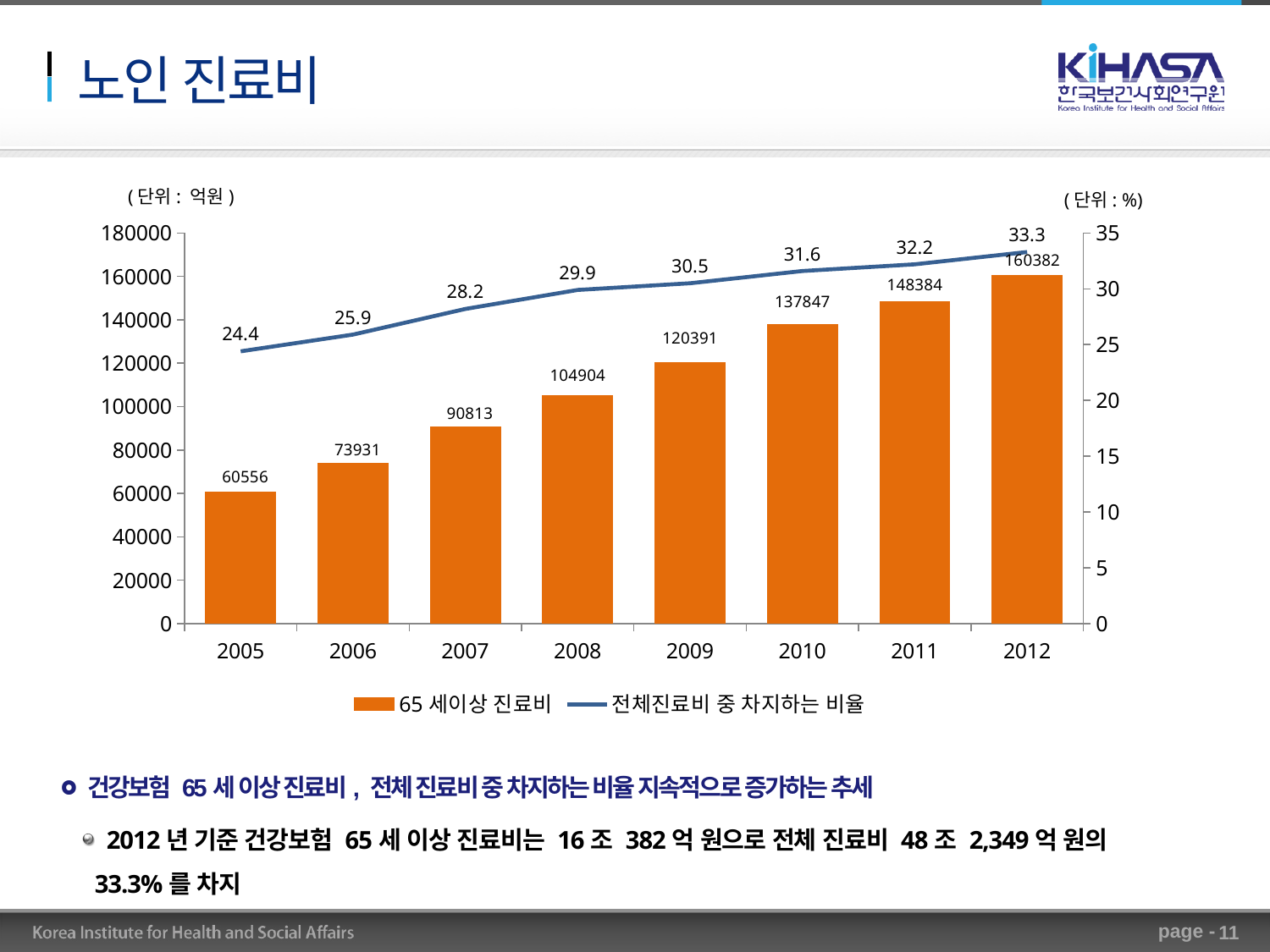
Which is larger, the 65세이상 진료비 for 2008 or for 2006? 2008 How many years are shown on the x axis? 8 What kind of chart is this? Combined bar and line chart Which year has the lowest 전체진료비 중 차지하는 비율? 2005 How many series does the legend list? 2 What is the value of 전체진료비 중 차지하는 비율 for 2007? 28.2 What is the difference in 65세이상 진료비 between 2012 and 2011? 11998 What is the difference in 전체진료비 중 차지하는 비율 between 2010 and 2005? 7.2 Which year has the highest 65세이상 진료비? 2012 What is the value of 65세이상 진료비 for 2009? 120391 What unit is shown for the left axis? 억원 Do the values of 65세이상 진료비 rise or fall from 2005 to 2012? Rise